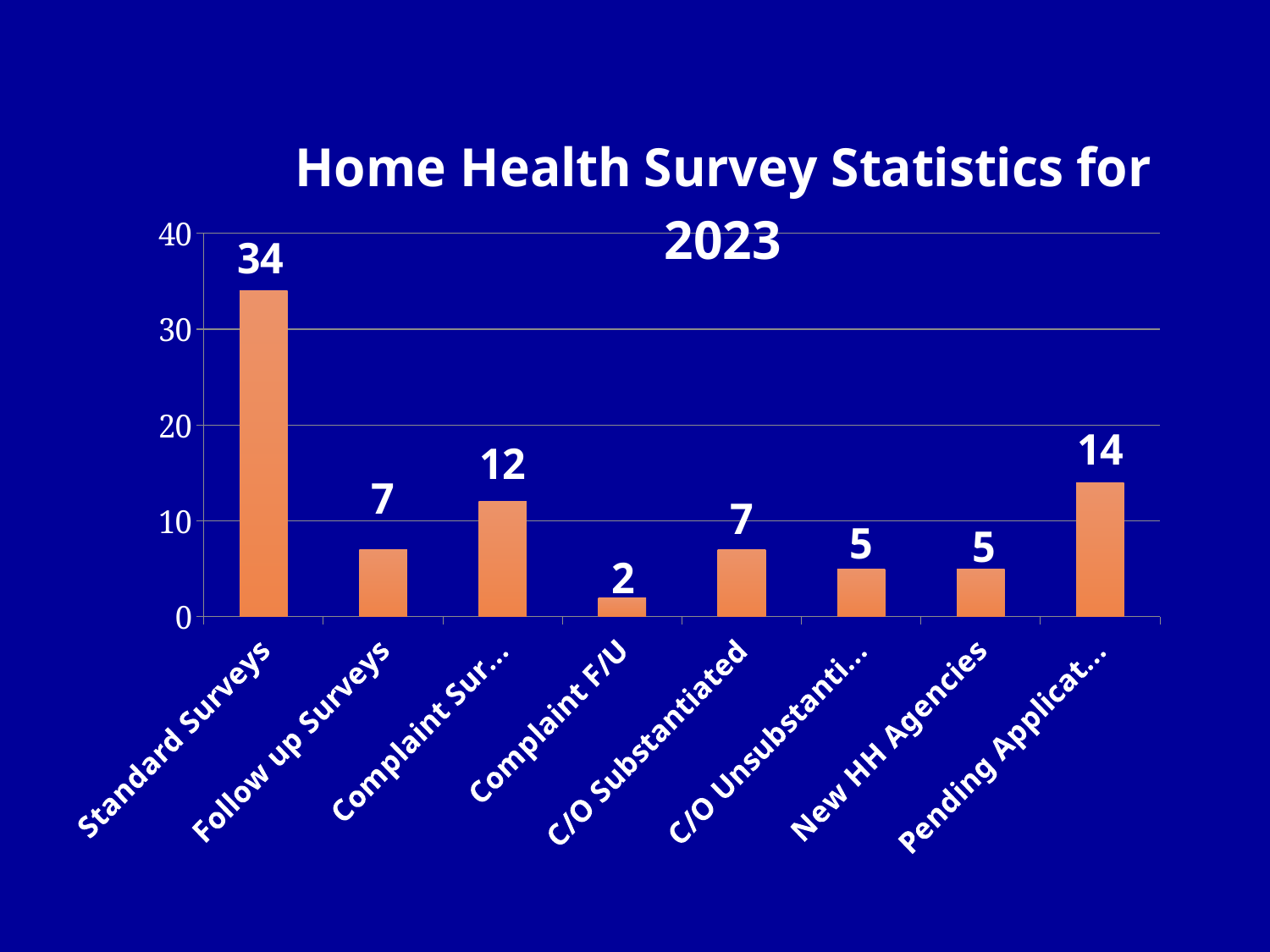
What kind of chart is shown on the slide? bar chart Is the value for Standard Surveys greater or less than 30? greater What is the value for New HH Agencies? 5 What is the value for C/O Substantiated? 7 What is the title of the chart? Home Health Survey Statistics for 2023 How many categories are shown on the chart? 8 What is the difference between the values for Standard Surveys and Follow up Surveys? 27 What is the value for Standard Surveys? 34 Which category has the highest value? Standard Surveys Which category has the lowest value? Complaint F/U Which is larger, the value for Follow up Surveys or the value for New HH Agencies? Follow up Surveys What is the value for Complaint F/U? 2